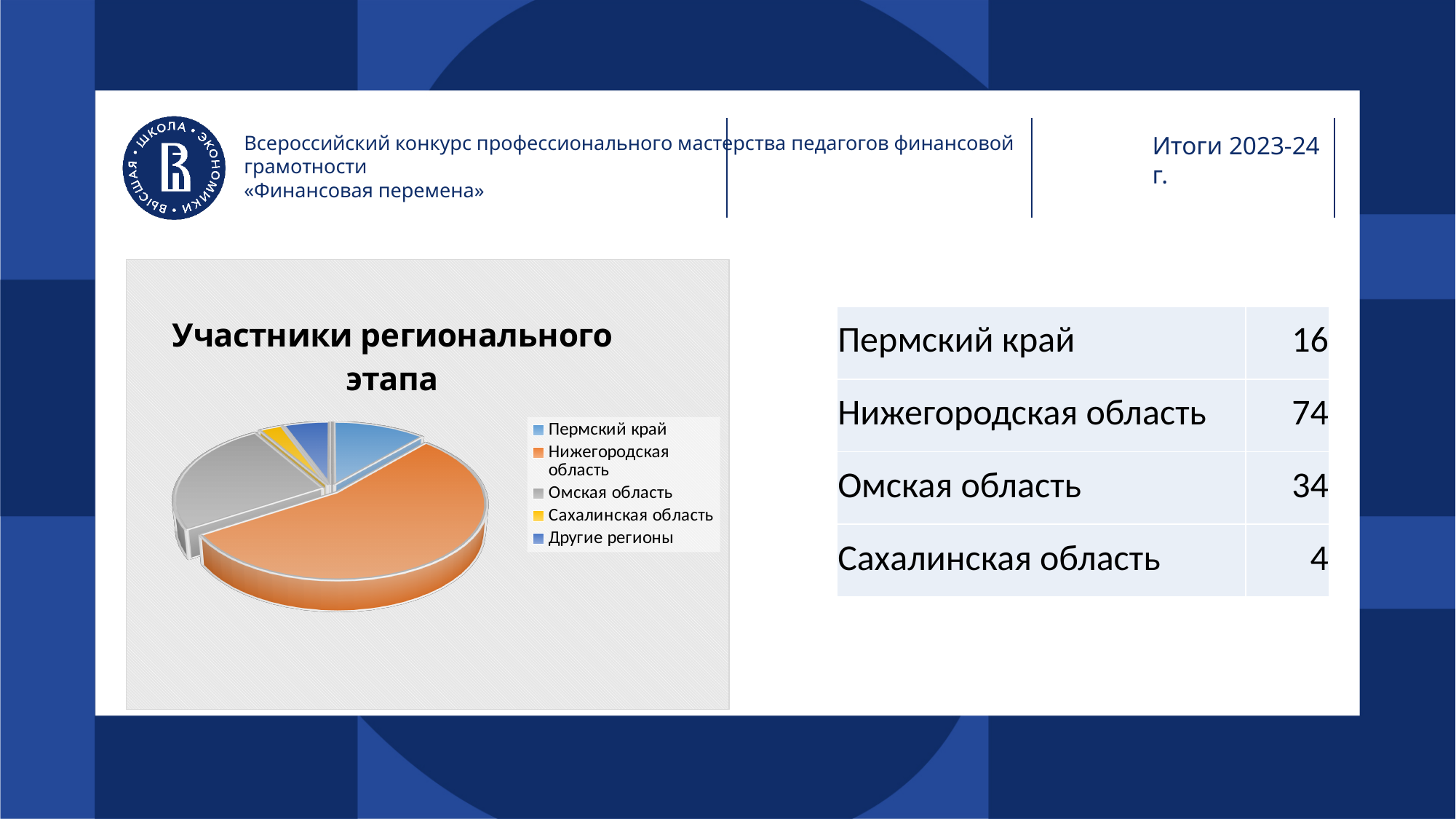
Which colour represents Нижегородская область in the pie chart? orange What kind of chart is shown on the slide? pie chart How many categories does the pie chart's legend list? 5 According to the table next to the chart, how many participants are from Омская область? 34 Which region has the largest slice in the pie chart? Нижегородская область What is the title of the pie chart? Участники регионального этапа According to the table next to the chart, how many participants are from Сахалинская область? 4 What is the difference between the number of participants from Нижегородская область and Омская область? 40 What is the difference between the number of participants from Пермский край and Сахалинская область? 12 Which slice is larger in the pie chart: Омская область or Пермский край? Омская область According to the table next to the chart, how many participants are from Нижегородская область? 74 According to the table next to the chart, how many participants are from Пермский край? 16